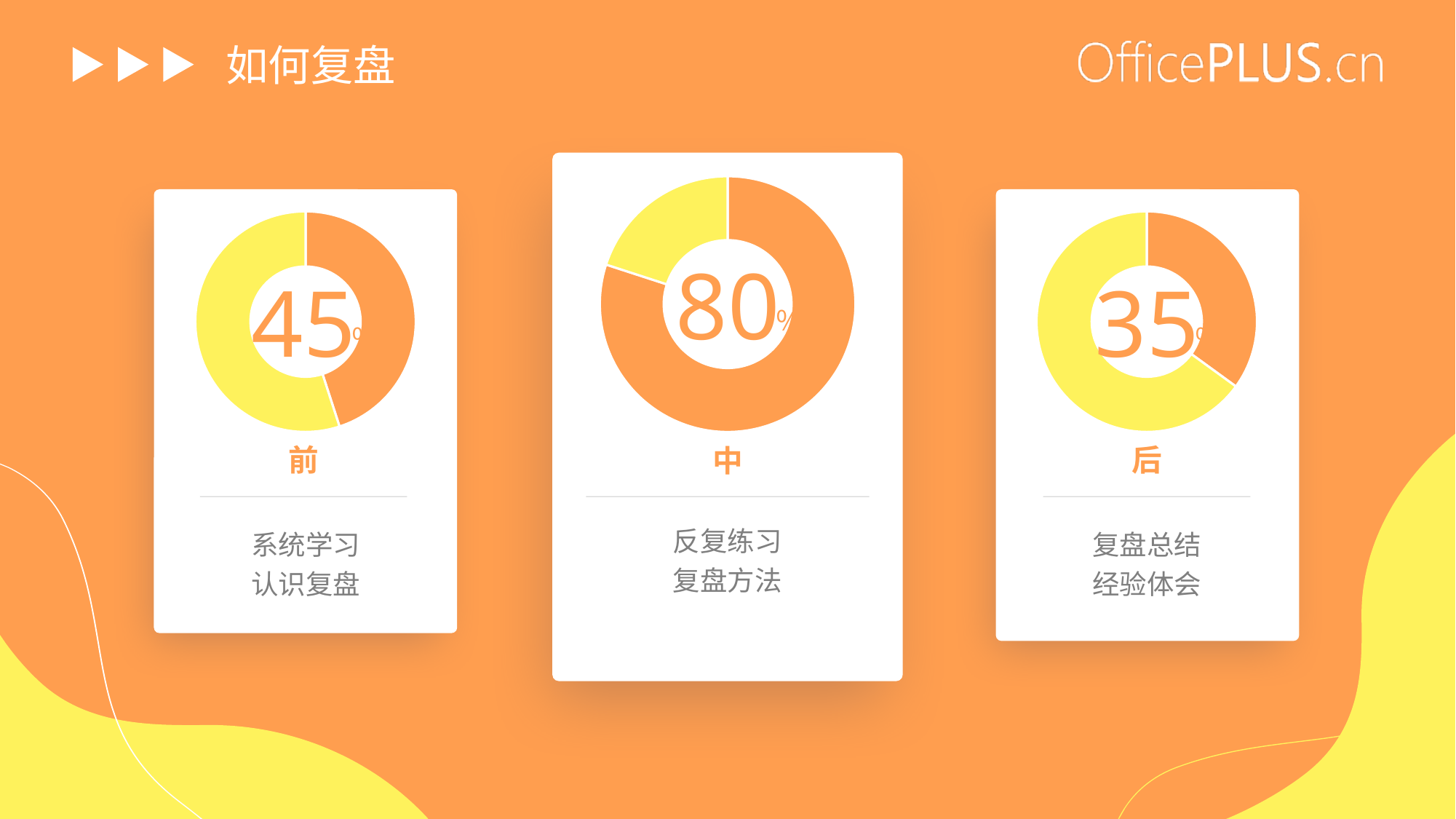
On the chart labelled 前 (left), what percentage is shown in the centre? 45% What is the label printed below the left chart? 前 Across the three charts 前, 中 and 后, which one shows the highest percentage? 中 What is the difference between the percentage on the 中 chart and the percentage on the 前 chart? 35% What kind of chart is used on the 中 (middle) card? Doughnut chart Across the three charts 前, 中 and 后, which one shows the lowest percentage? 后 How many doughnut charts are shown on the slide? 3 On the chart labelled 后 (right), what percentage is shown in the centre? 35% On the 中 (middle) chart, what colour is the slice representing the 80% share? Orange Which is larger, the percentage on the 前 chart or the percentage on the 后 chart? 前 What is the difference between the percentage on the 前 chart and the percentage on the 后 chart? 10% On the chart labelled 中 (middle), what percentage is shown in the centre? 80%